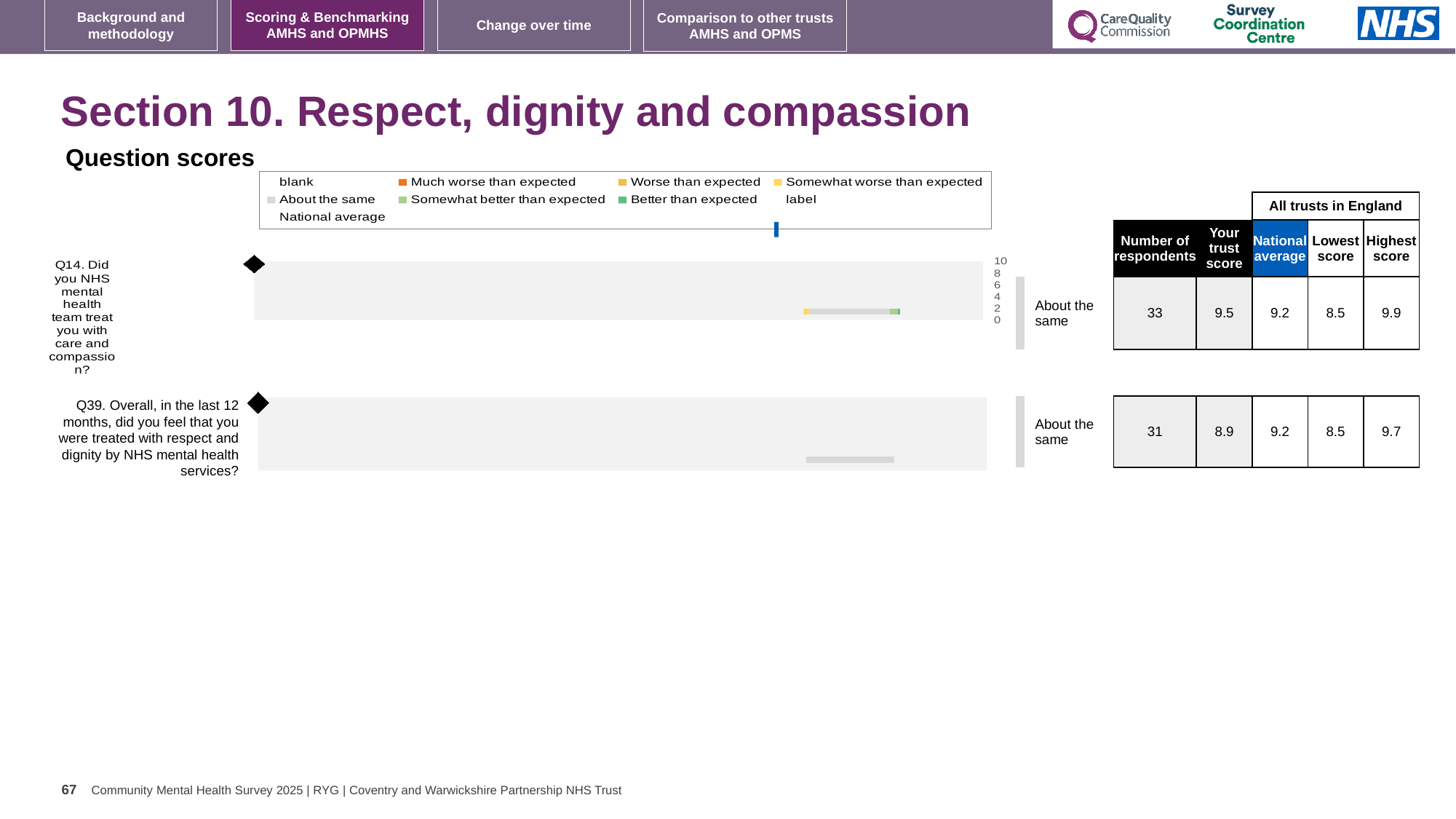
How many questions are plotted in the 'Question scores' chart? 2 By how much does the trust score for Q14 exceed the national average? 0.3 What benchmark category is shown for Q39? About the same How many respondents answered Q39? 31 What is the trust score for Q14 (care and compassion)? 9.5 What is the highest score among all trusts in England for Q14? 9.9 Which question has the higher trust score, Q14 or Q39? Q14 How many respondents answered Q14? 33 What is the trust score for Q39 (respect and dignity)? 8.9 What kind of chart is shown under 'Question scores'? bar chart What is the difference between the highest and lowest scores for Q39? 1.2 What is the national average score for Q39? 9.2